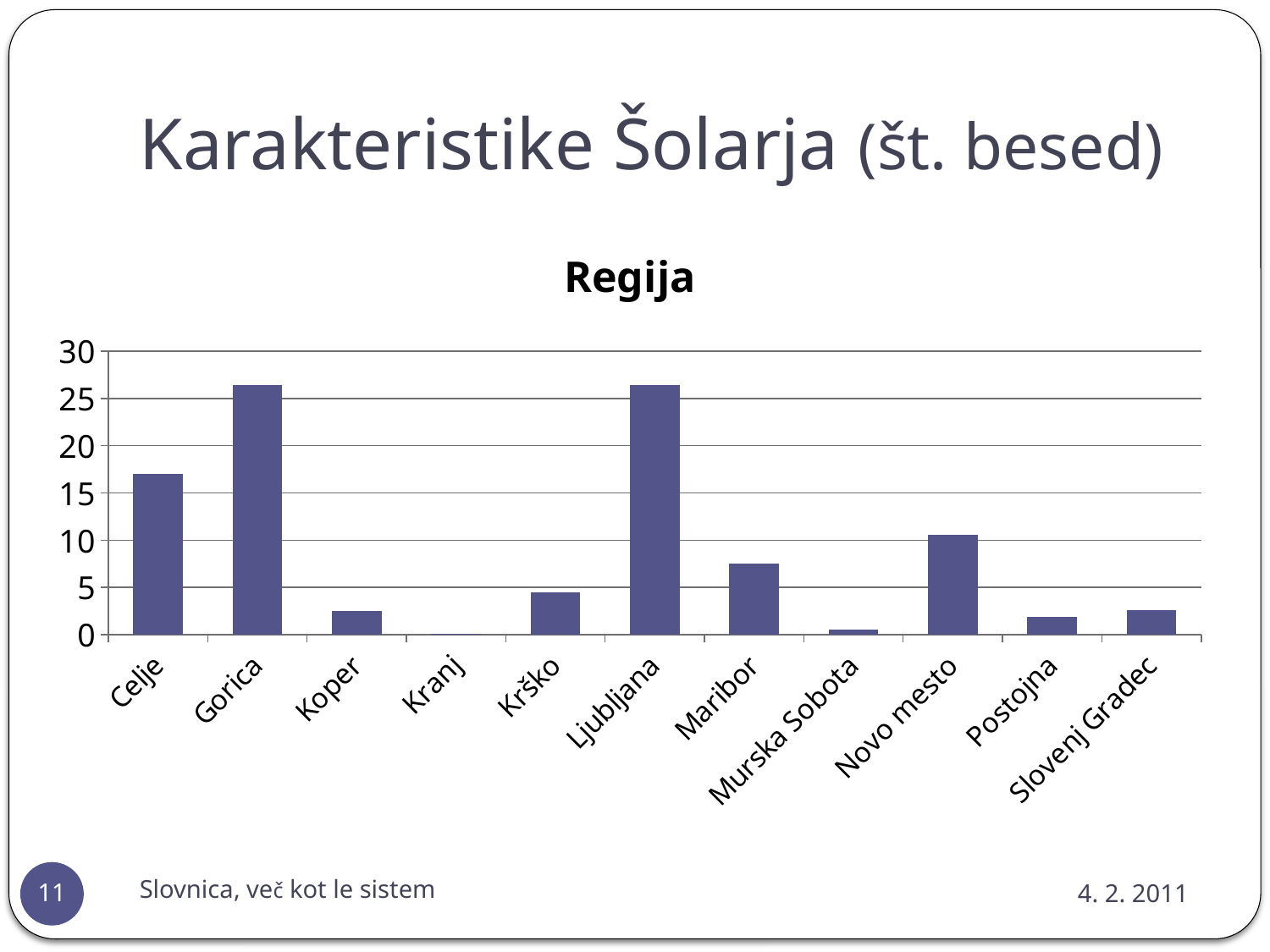
What kind of chart is shown on the slide? bar chart Which has a larger value, Novo mesto or Postojna? Novo mesto What is the title of the chart? Regija How many regions (categories) are shown on the x axis of the chart? 11 Is the value for Ljubljana greater or less than 20? greater Which has a larger value, Celje or Maribor? Celje Which region has the lowest value in the chart? Kranj Is the value for Celje greater or less than 15? greater Is the value for Maribor greater or less than 10? less